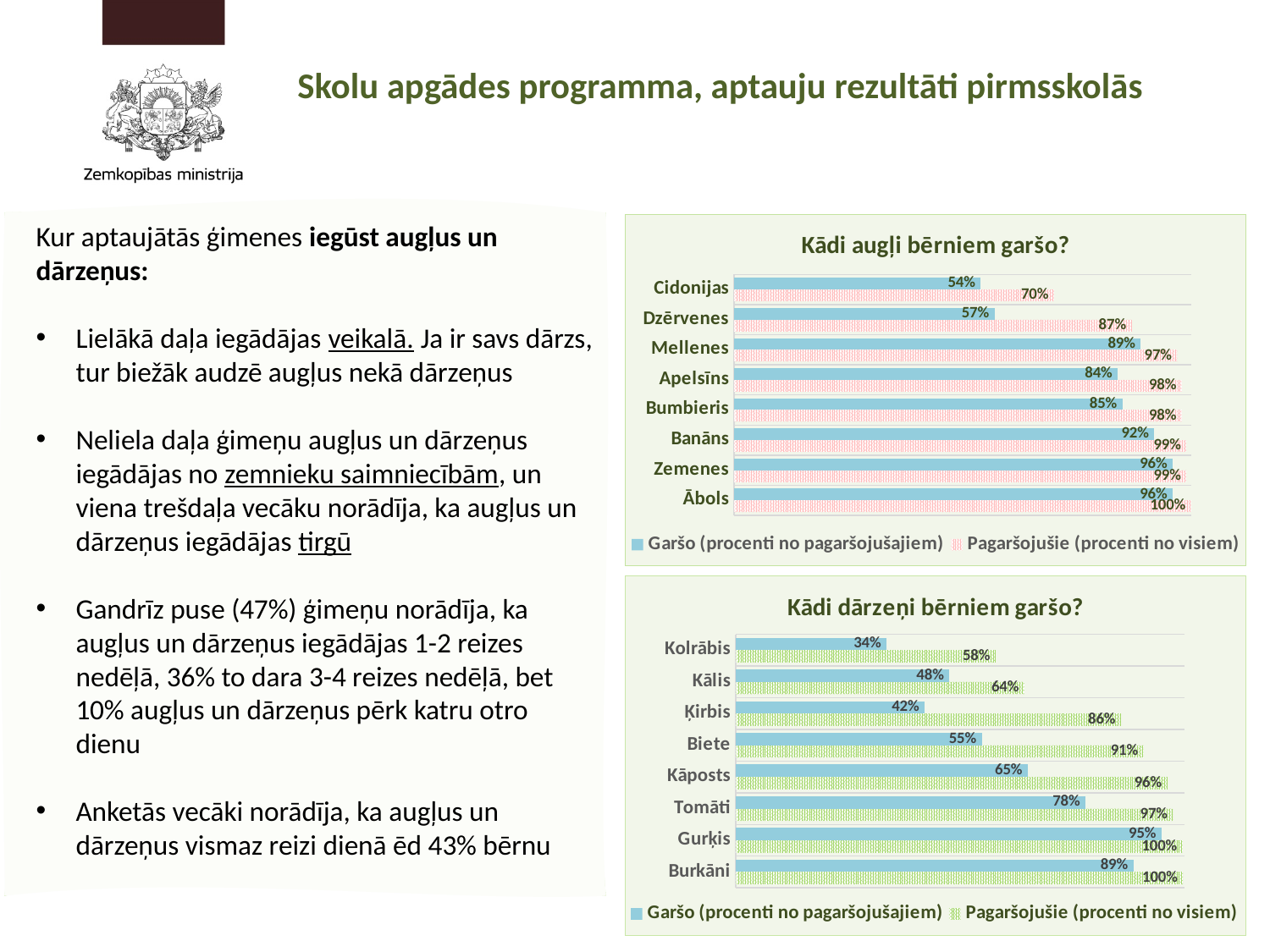
In the chart "Kādi augļi bērniem garšo?", what is the value of "Garšo (procenti no pagaršojušajiem)" for Cidonijas? 54% In the chart "Kādi dārzeņi bērniem garšo?", what is the difference between the "Pagaršojušie (procenti no visiem)" values for Kolrābis and Kālis? 6% What type of chart is "Kādi dārzeņi bērniem garšo?"? Bar chart In the chart "Kādi augļi bērniem garšo?", how many fruit categories are shown? 8 In the chart "Kādi dārzeņi bērniem garšo?", what is the value of "Pagaršojušie (procenti no visiem)" for Ķirbis? 86% In the chart "Kādi dārzeņi bērniem garšo?", which is larger: the "Garšo (procenti no pagaršojušajiem)" value for Kāposts or for Biete? Kāposts In the chart "Kādi dārzeņi bērniem garšo?", what is the value of "Garšo (procenti no pagaršojušajiem)" for Tomāti? 78% In the chart "Kādi augļi bērniem garšo?", what is the value of "Pagaršojušie (procenti no visiem)" for Dzērvenes? 87% In the chart "Kādi augļi bērniem garšo?", how many series does the legend list? 2 In the chart "Kādi augļi bērniem garšo?", which fruit has the lowest value for "Garšo (procenti no pagaršojušajiem)"? Cidonijas In the chart "Kādi augļi bērniem garšo?", what is the difference between the two series values for Cidonijas? 16% In the chart "Kādi dārzeņi bērniem garšo?", which vegetable has the highest value for "Garšo (procenti no pagaršojušajiem)"? Gurķis